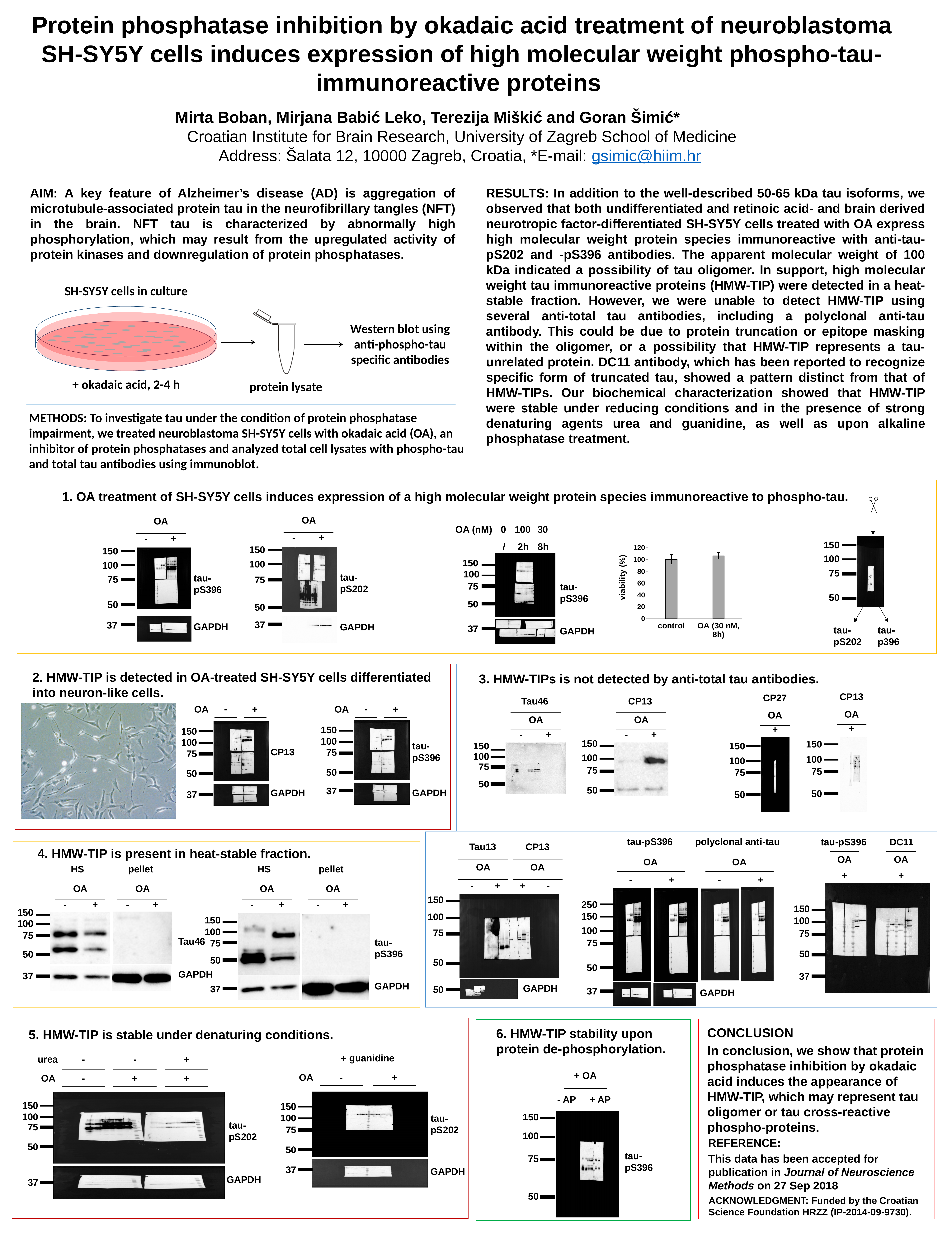
What is the highest tick value shown on the y axis of the viability (%) bar chart? 120 What is the label of the y axis on the bar chart in panel 1? viability (%) What are the two category labels on the x axis of the viability (%) bar chart? control and OA (30 nM, 8h) In the viability (%) bar chart, is the value for OA (30 nM, 8h) greater or less than 80? greater How many categories are shown on the x axis of the viability (%) bar chart? 2 In the viability (%) bar chart, is the value for control greater or less than 60? greater In the viability (%) bar chart, is the value for OA (30 nM, 8h) greater or less than 120? less What kind of chart is the viability (%) chart in panel 1? bar chart